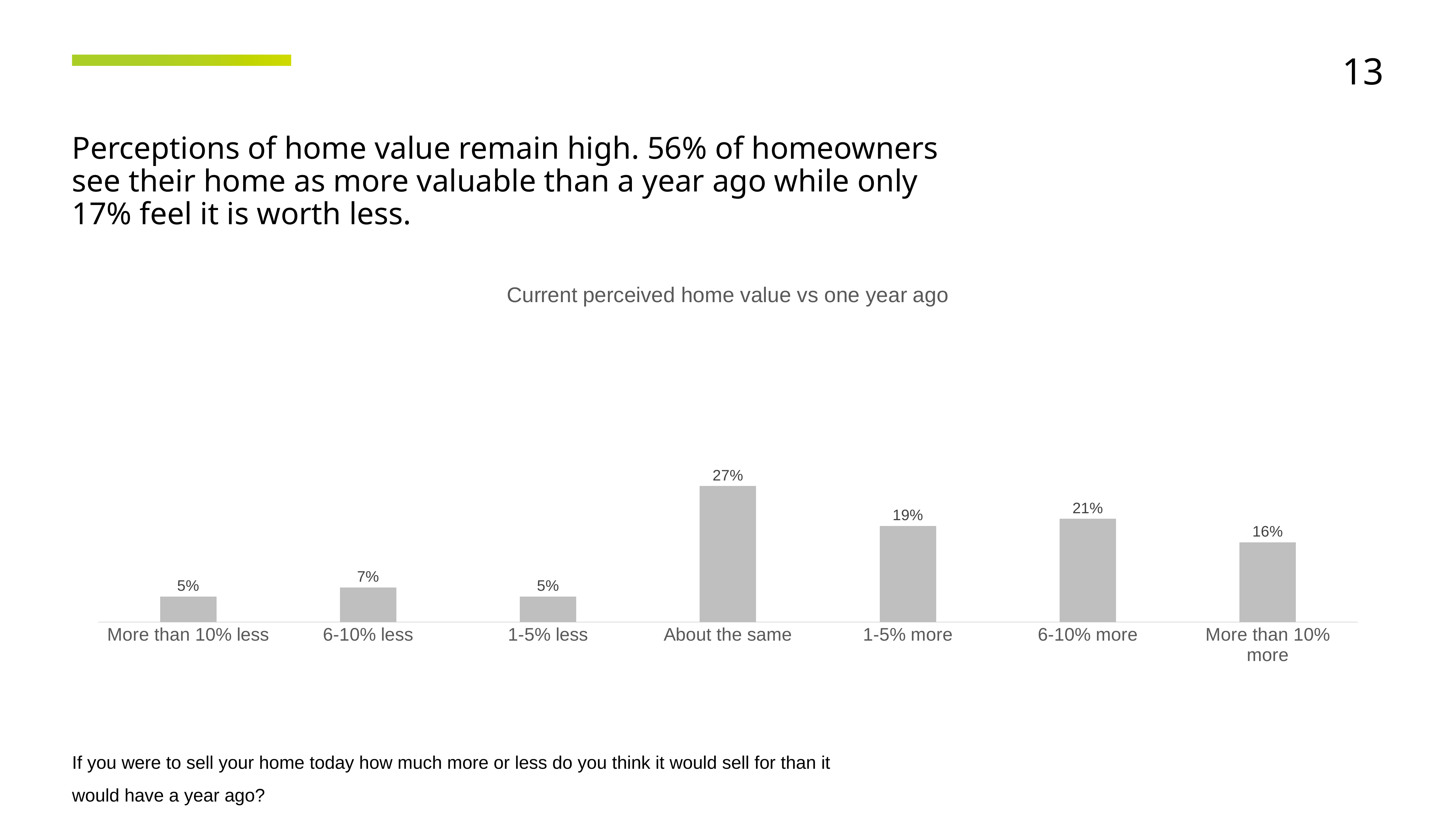
Which is larger, the value for "1-5% more" or the value for "6-10% more"? 6-10% more What is the value for "More than 10% more"? 16% What is the difference between the values for "6-10% more" and "More than 10% more"? 5% What is the value for "About the same"? 27% What is the title of the chart? Current perceived home value vs one year ago Which is larger, the value for "6-10% less" or the value for "1-5% less"? 6-10% less Which category has the highest value? About the same What kind of chart is shown on the slide? Bar chart What is the value for "6-10% more"? 21% What is the value for "6-10% less"? 7% What is the difference between the values for "About the same" and "1-5% more"? 8% How many categories are shown in the chart? 7